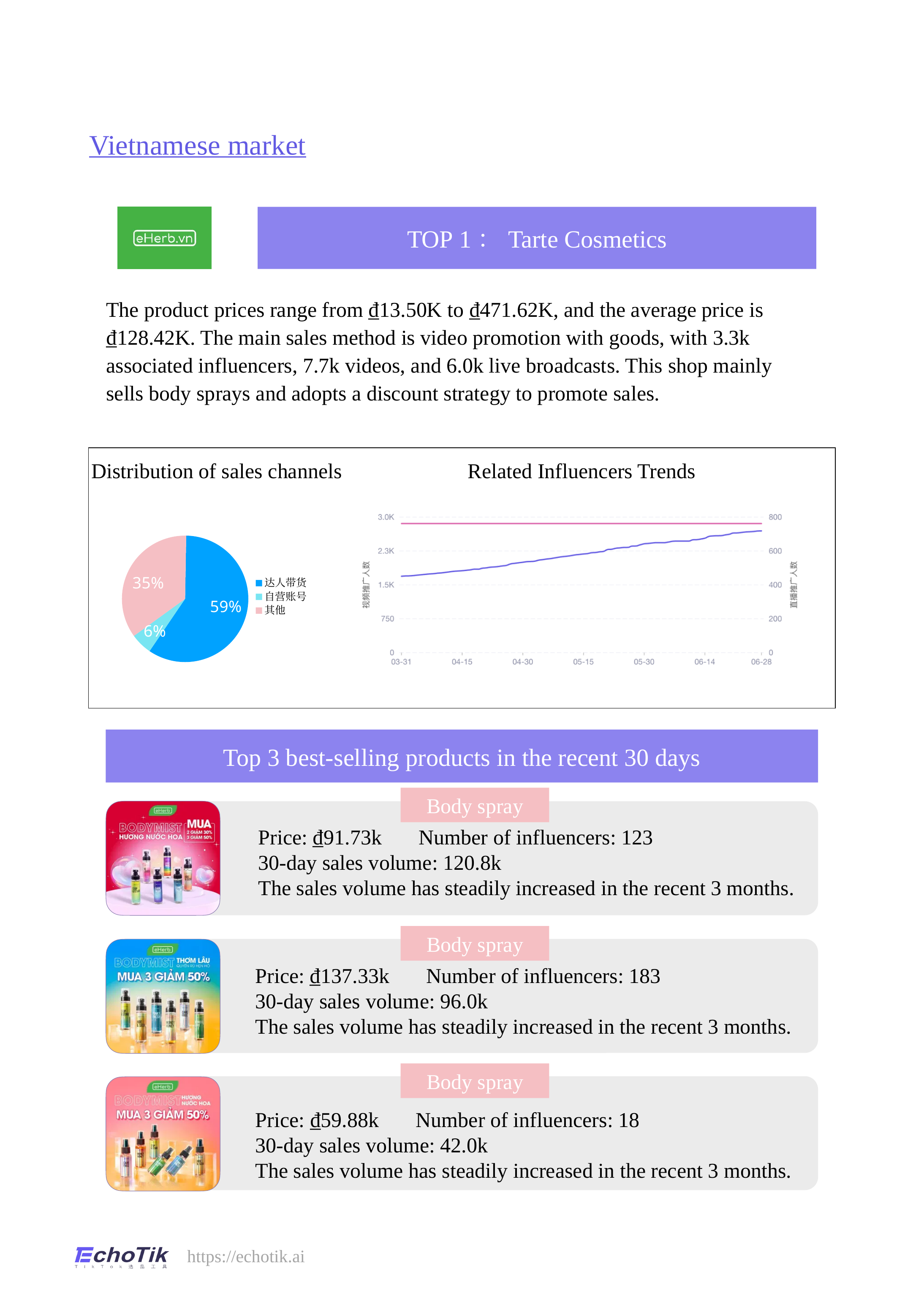
In the 'Distribution of sales channels' chart, what share does the 达人带货 slice have? 59% In the 'Distribution of sales channels' chart, what colour is the 其他 slice? Pink What kind of chart is 'Related Influencers Trends'? Line chart In the 'Related Influencers Trends' chart, does the purple line rise or fall from 03-31 to 06-28? Rise In the 'Distribution of sales channels' chart, how many slices does the pie have? 3 In the 'Distribution of sales channels' chart, which category has the largest share? 达人带货 In the 'Distribution of sales channels' chart, what is the difference in percentage points between the 达人带货 and 其他 slices? 24 In the 'Distribution of sales channels' chart, what share does the 其他 slice have? 35% What kind of chart is 'Distribution of sales channels'? Pie chart In the 'Distribution of sales channels' chart, what share does the 自营账号 slice have? 6% In the 'Distribution of sales channels' chart, which category has the smallest share? 自营账号